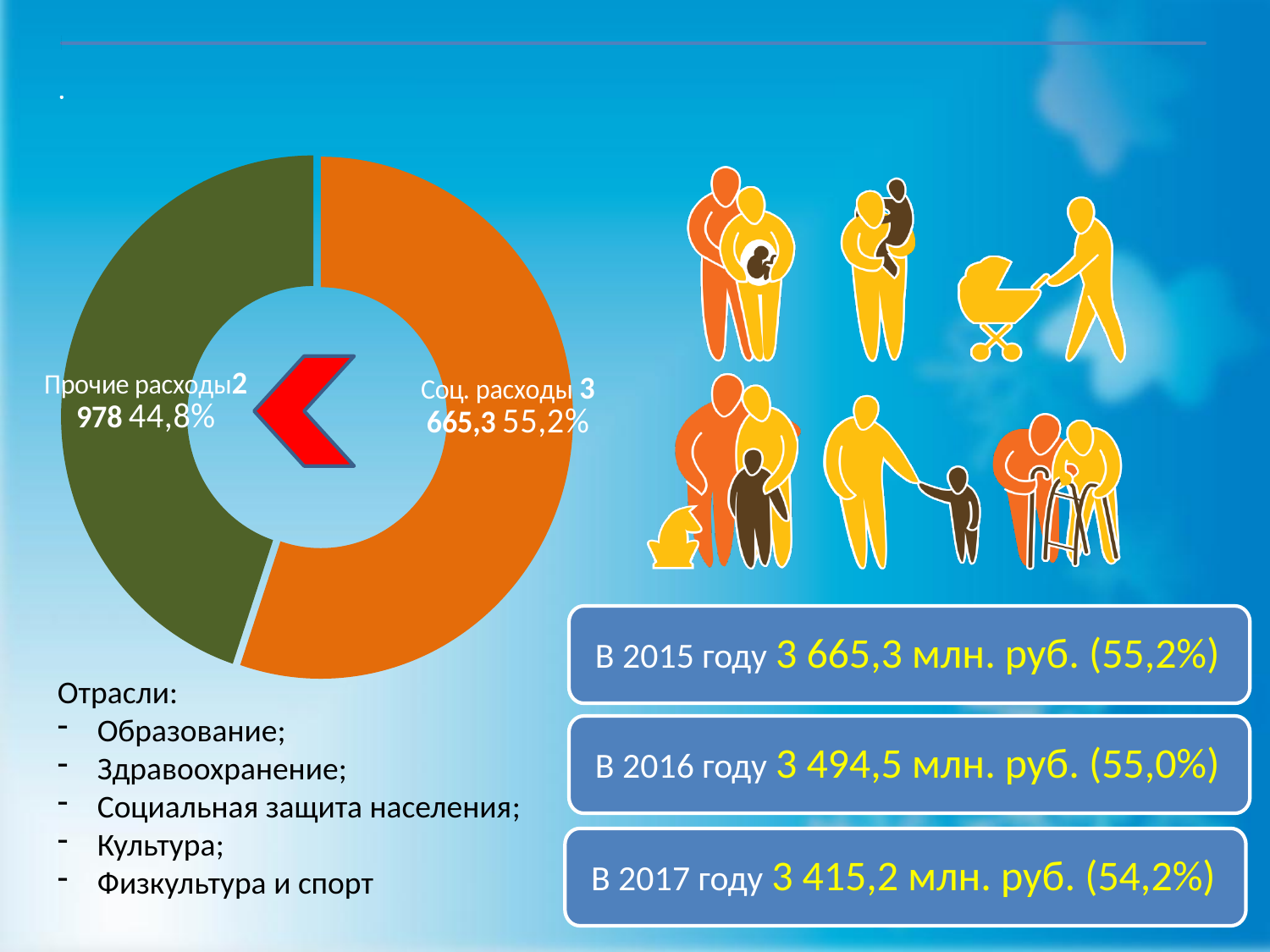
Which is larger in the doughnut chart, "Соц. расходы" or "Прочие расходы"? Соц. расходы What is the value shown for "Прочие расходы" in the doughnut chart? 2 978 Which slice of the doughnut chart is the smallest? Прочие расходы What colour is the "Соц. расходы" slice in the doughnut chart? orange What is the difference between the values of "Соц. расходы" and "Прочие расходы" in the doughnut chart? 687,3 What share of the doughnut chart does "Прочие расходы" represent? 44,8% Which slice of the doughnut chart is the largest? Соц. расходы What share of the doughnut chart does "Соц. расходы" represent? 55,2% What kind of chart is shown on the slide? doughnut chart How many slices does the doughnut chart have? 2 What is the value shown for "Соц. расходы" in the doughnut chart? 3 665,3 By how many percentage points does the share of "Соц. расходы" exceed the share of "Прочие расходы" in the doughnut chart? 10,4